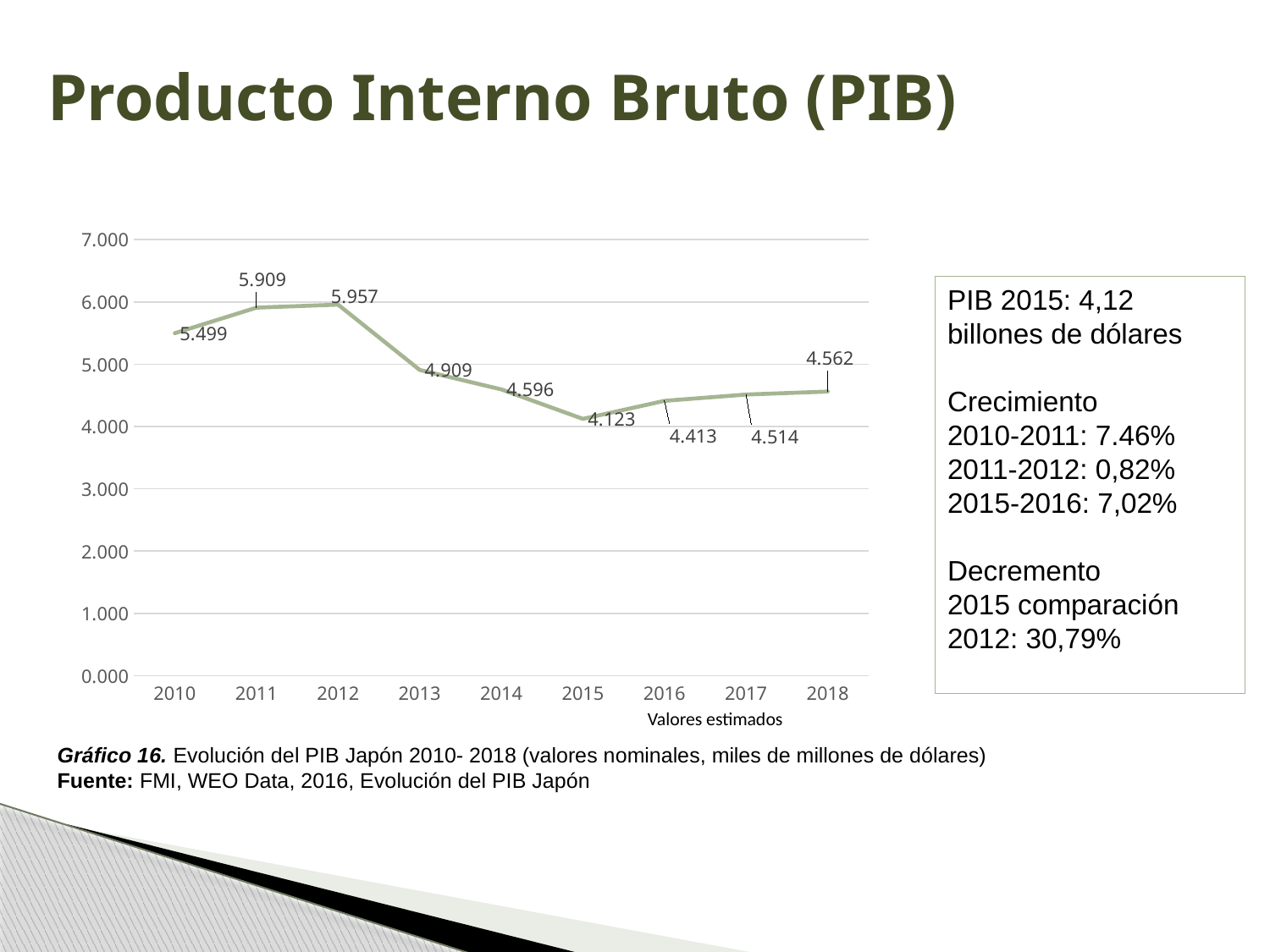
What is the PIB value plotted for 2015? 4.123 What type of chart is shown on the slide? line chart What is the PIB value plotted for 2010? 5.499 Which year has a larger PIB value, 2013 or 2016? 2013 Which year has the lowest PIB value in the chart? 2015 Do the PIB values rise or fall from 2015 to 2018? rise Do the PIB values rise or fall from 2012 to 2015? fall What note appears below the x axis at the right of the chart? Valores estimados What is the PIB value plotted for 2018? 4.562 How many years are plotted on the x axis of the chart? 9 What is the difference between the PIB values for 2012 and 2015? 1.834 Which year has the highest PIB value in the chart? 2012